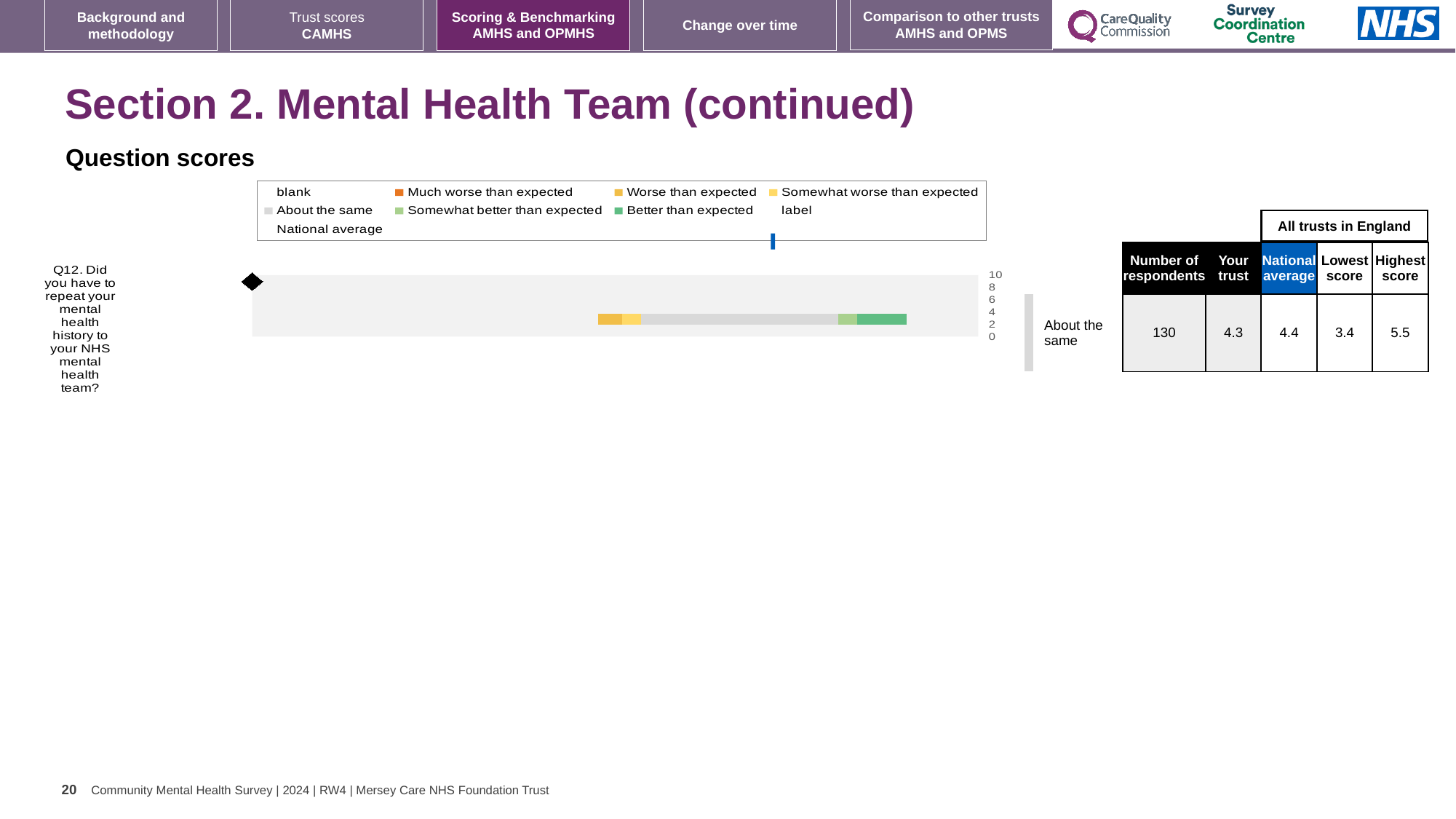
Which is larger for Q12, the 'Your trust' score or the national average? National average What is the highest score among all trusts in England for Q12? 5.5 What is the difference between the national average and the 'Your trust' score for Q12? 0.1 What kind of chart is used to show the Q12 question score? bar chart Which legend entry does the grey segment of the bar represent? About the same How many questions are plotted on the chart? 1 How many respondents answered Q12? 130 What is the national average score for Q12? 4.4 What is the 'Your trust' score for Q12? 4.3 What is the lowest score among all trusts in England for Q12? 3.4 What is the difference between the highest score and the lowest score for Q12? 2.1 What is the highest value shown on the chart's axis? 10